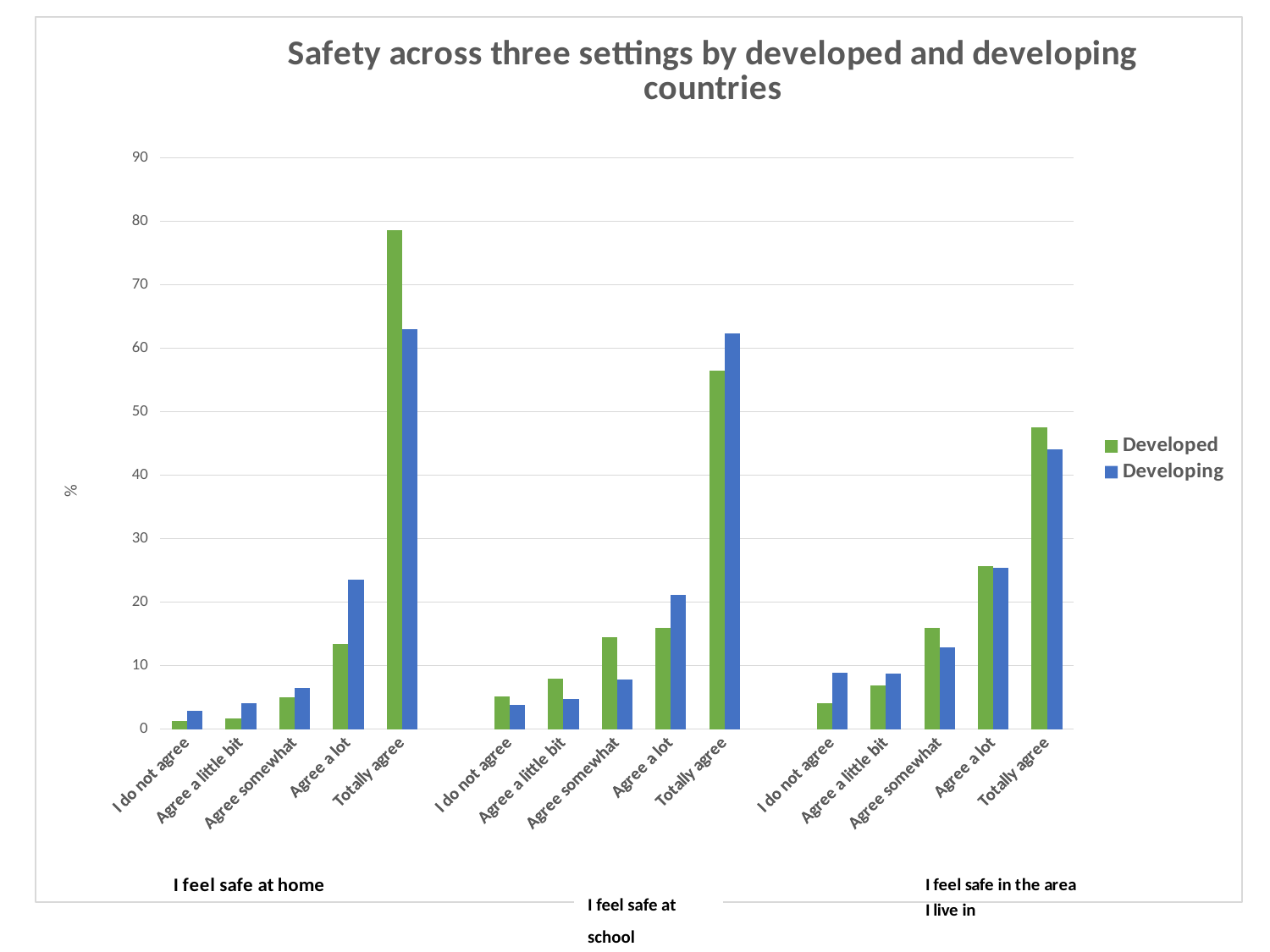
Is the Developing value for 'Agree a lot' under 'I feel safe at home' greater or less than 20? greater How many series does the legend list? 2 Is the Developed value for 'Totally agree' under 'I feel safe in the area I live in' greater or less than 50? less For 'Totally agree' under 'I feel safe at school', which series has the larger value, Developed or Developing? Developing Is the Developed value for 'Totally agree' under 'I feel safe at home' greater or less than 70? greater Which bar is the tallest in the chart? Developed, Totally agree, I feel safe at home For 'Agree a lot' under 'I feel safe at home', which series has the larger value, Developed or Developing? Developing How many response categories are shown for the setting 'I feel safe at home'? 5 What kind of chart is shown on the slide? bar chart Which colour represents the Developed series in the legend? green How many settings (groups of bars) are shown along the x axis? 3